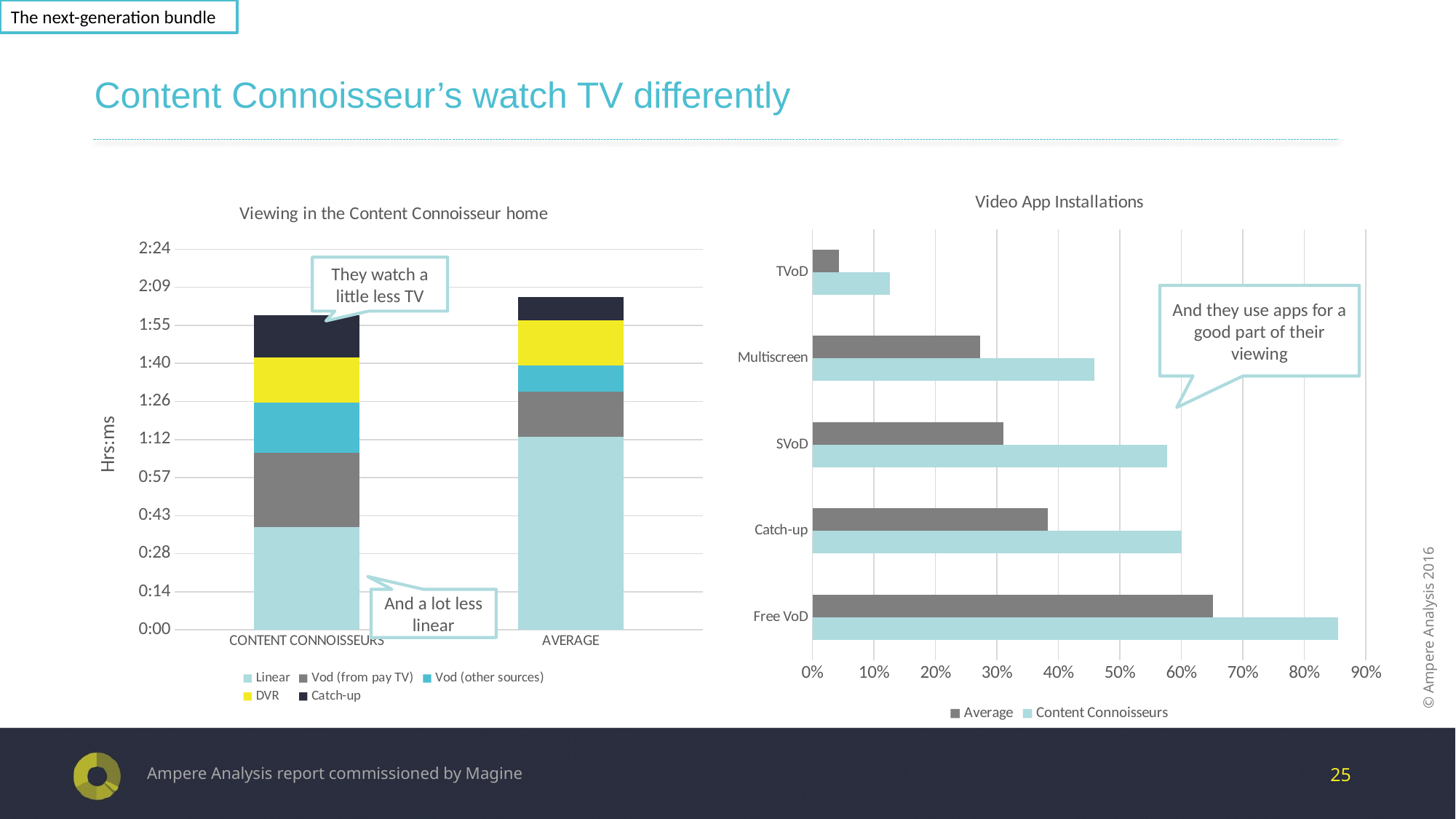
In the 'Video App Installations' chart, is the Average value for TVoD greater or less than 10%? less In the 'Viewing in the Content Connoisseur home' chart, which category has the larger Linear segment: CONTENT CONNOISSEURS or AVERAGE? AVERAGE In the 'Video App Installations' chart, is the Content Connoisseurs value for Free VoD greater or less than 80%? greater In the 'Video App Installations' chart, which is larger for SVoD: the Average value or the Content Connoisseurs value? Content Connoisseurs In the 'Video App Installations' chart, is the Content Connoisseurs value for Multiscreen greater or less than 40%? greater In the 'Video App Installations' chart, which category has the highest value for Content Connoisseurs? Free VoD In the 'Video App Installations' chart, which category has the lowest value for Average? TVoD How many series does the legend of the 'Viewing in the Content Connoisseur home' chart list? 5 What type of chart is the 'Video App Installations' chart? bar chart How many series does the legend of the 'Video App Installations' chart list? 2 How many categories are shown on the 'Video App Installations' chart? 5 What is the y-axis label of the 'Viewing in the Content Connoisseur home' chart? Hrs:ms